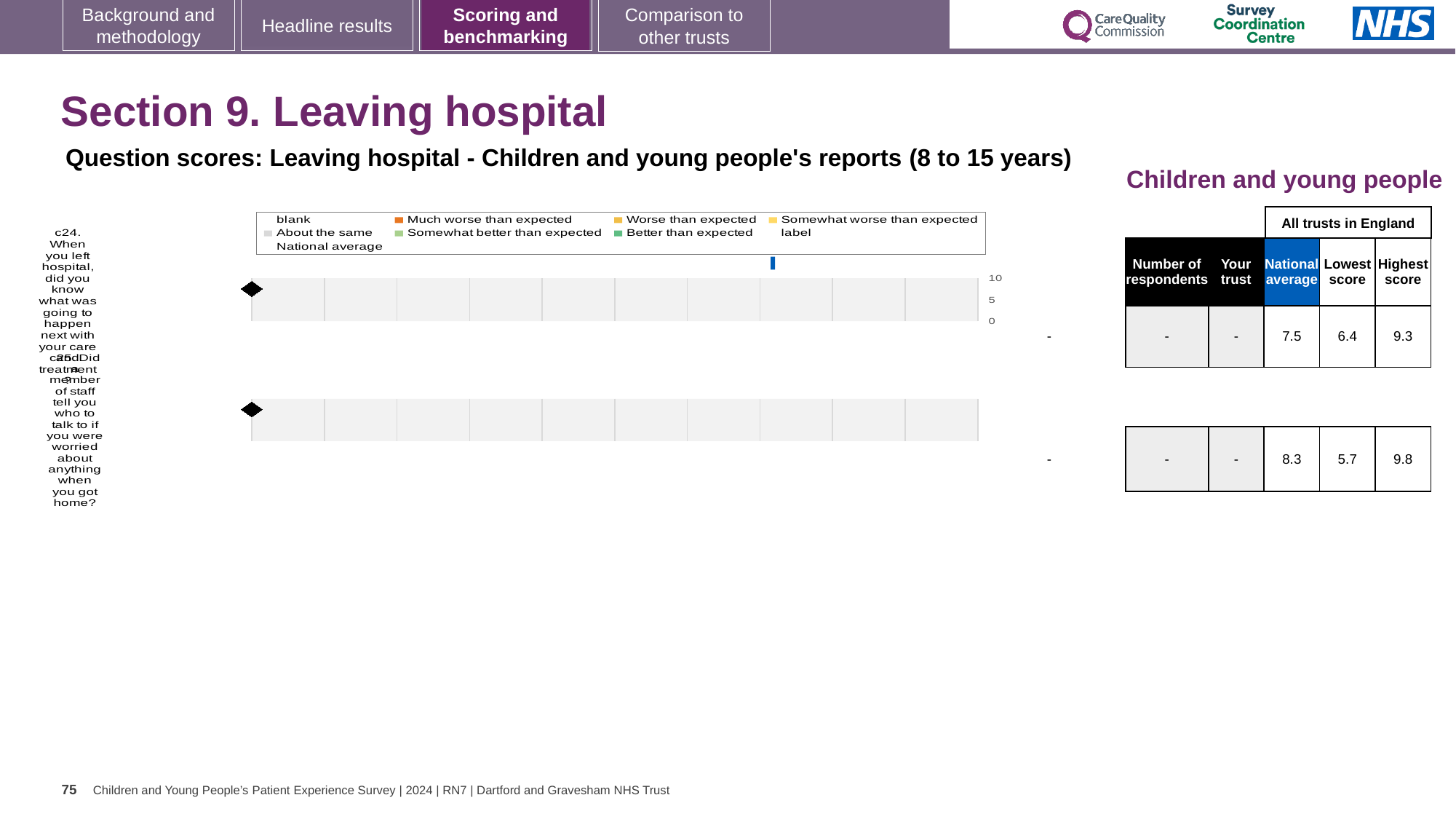
Which question has the higher National average in the table, c24 or c25? c25 What kind of chart is shown on the slide? bar chart How many questions (categories) are plotted in the chart? 2 What value is shown for Your trust for question c24? - Which legend entry is shown with an orange marker? Much worse than expected What is the difference between the Highest score and the Lowest score for question c25? 4.1 What is the highest tick value shown on the chart's axis? 10 In the table, what is the National average score for question c24? 7.5 In the table, what is the Highest score for question c24? 9.3 In the table, what is the Lowest score for question c25? 5.7 How many entries does the chart legend list? 9 What is the difference between the Highest score and the Lowest score for question c24? 2.9